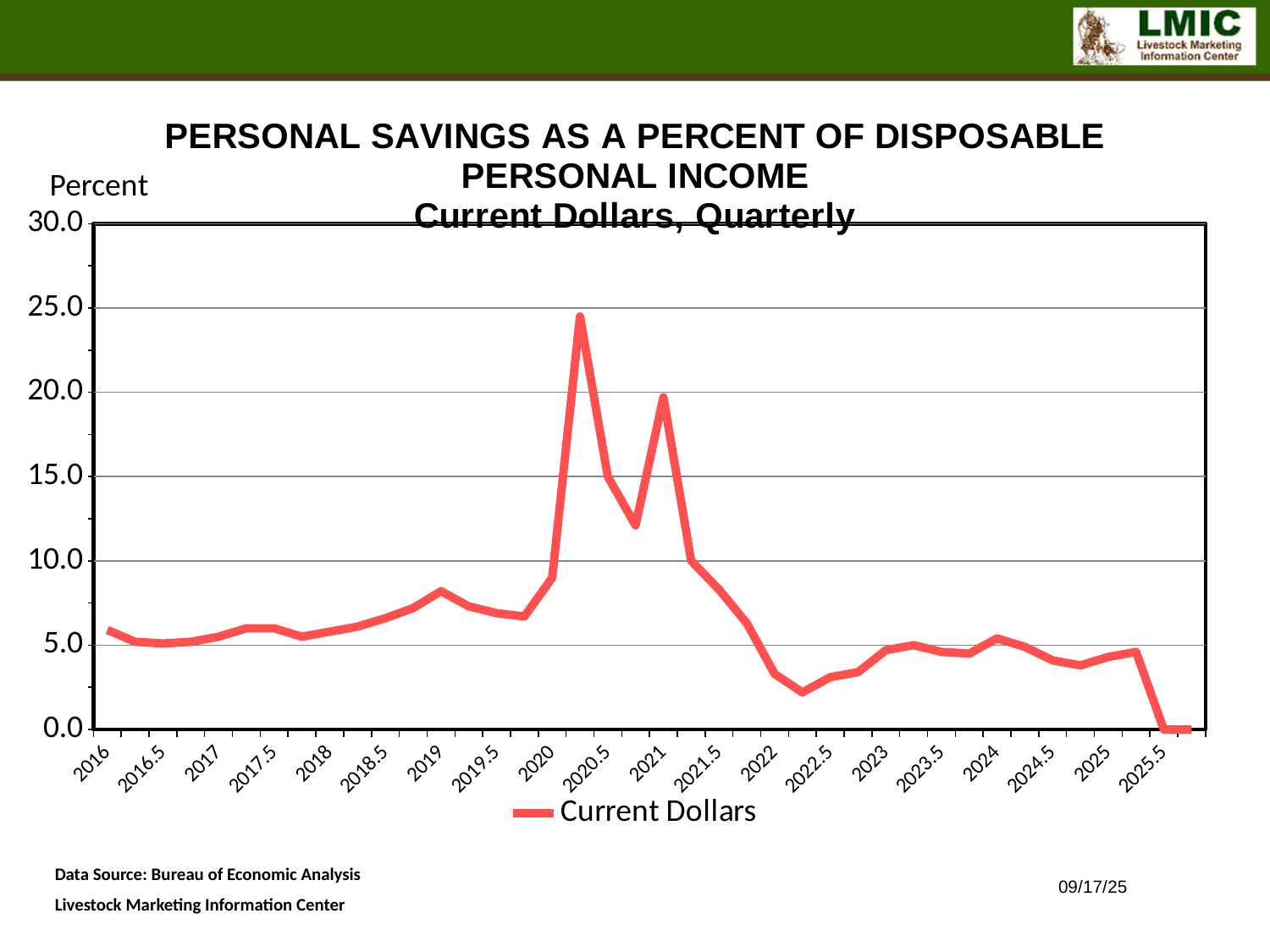
Which is larger, the value for 2019 or the value for 2023? 2019 How many series does the legend list? 1 What kind of chart is shown on the slide? line chart Do the values rise or fall between 2021 and 2022.5? fall Which is larger, the value for 2020.5 or the value for 2022? 2020.5 Is the value for 2023.5 greater or less than 10.0? less What label is shown on the vertical axis of the chart? Percent Is the value for 2022.5 greater or less than 5.0? less Is the value for 2019 greater or less than 5.0? greater What is the name of the series shown in the legend? Current Dollars